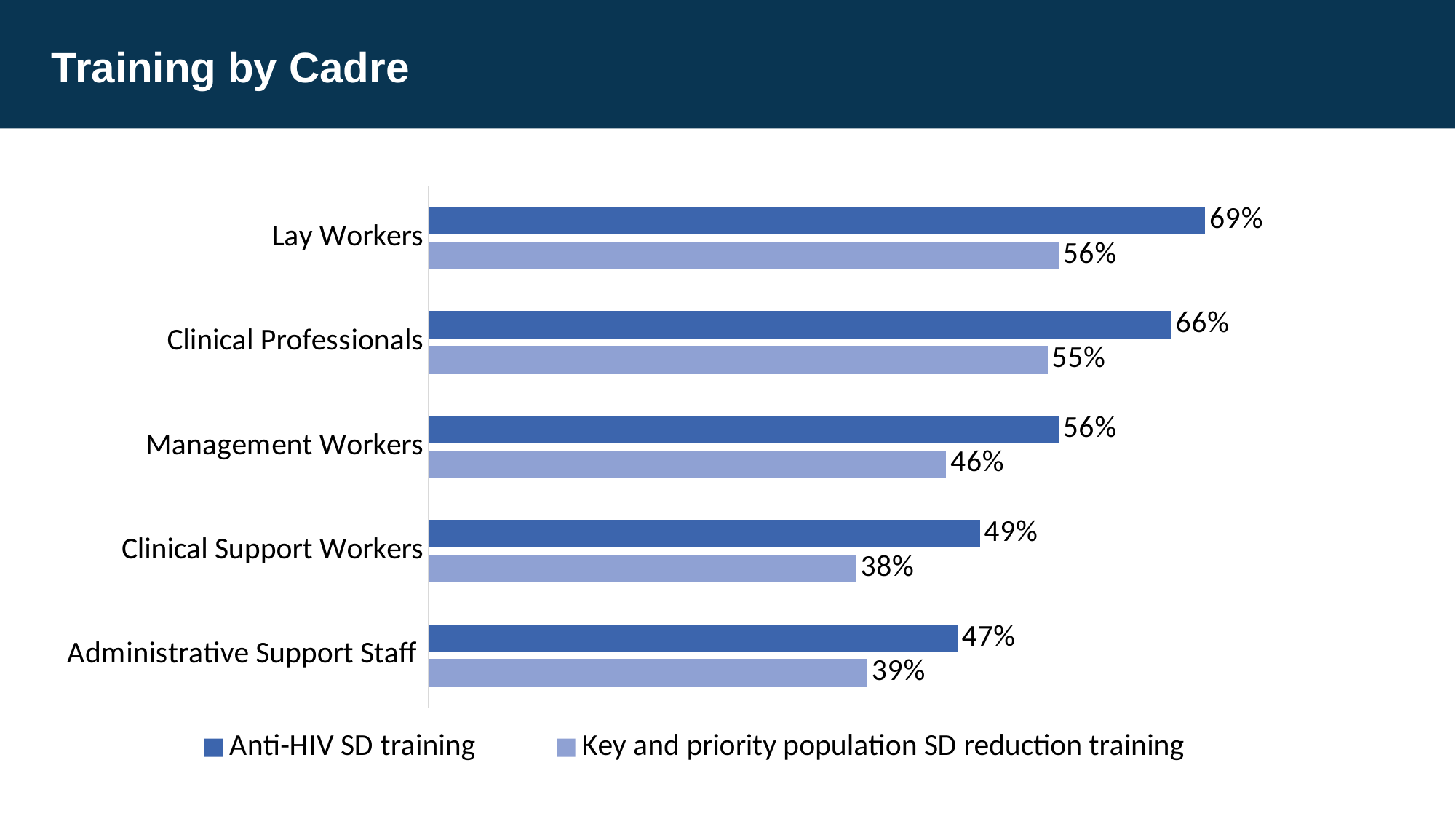
What is the Key and priority population SD reduction training value for Clinical Support Workers? 38% What is the title of the slide? Training by Cadre Which cadre has the lowest Key and priority population SD reduction training value? Clinical Support Workers How many cadres are shown on the chart? 5 Which cadre has the highest Anti-HIV SD training value? Lay Workers What is the Anti-HIV SD training value for Lay Workers? 69% Which is larger for Clinical Professionals: Anti-HIV SD training or Key and priority population SD reduction training? Anti-HIV SD training How many series does the legend list? 2 What is the difference between the Anti-HIV SD training values for Lay Workers and Administrative Support Staff? 22% What is the difference between the Anti-HIV SD training and Key and priority population SD reduction training values for Management Workers? 10% What kind of chart is shown on the slide? Bar chart What is the Anti-HIV SD training value for Administrative Support Staff? 47%